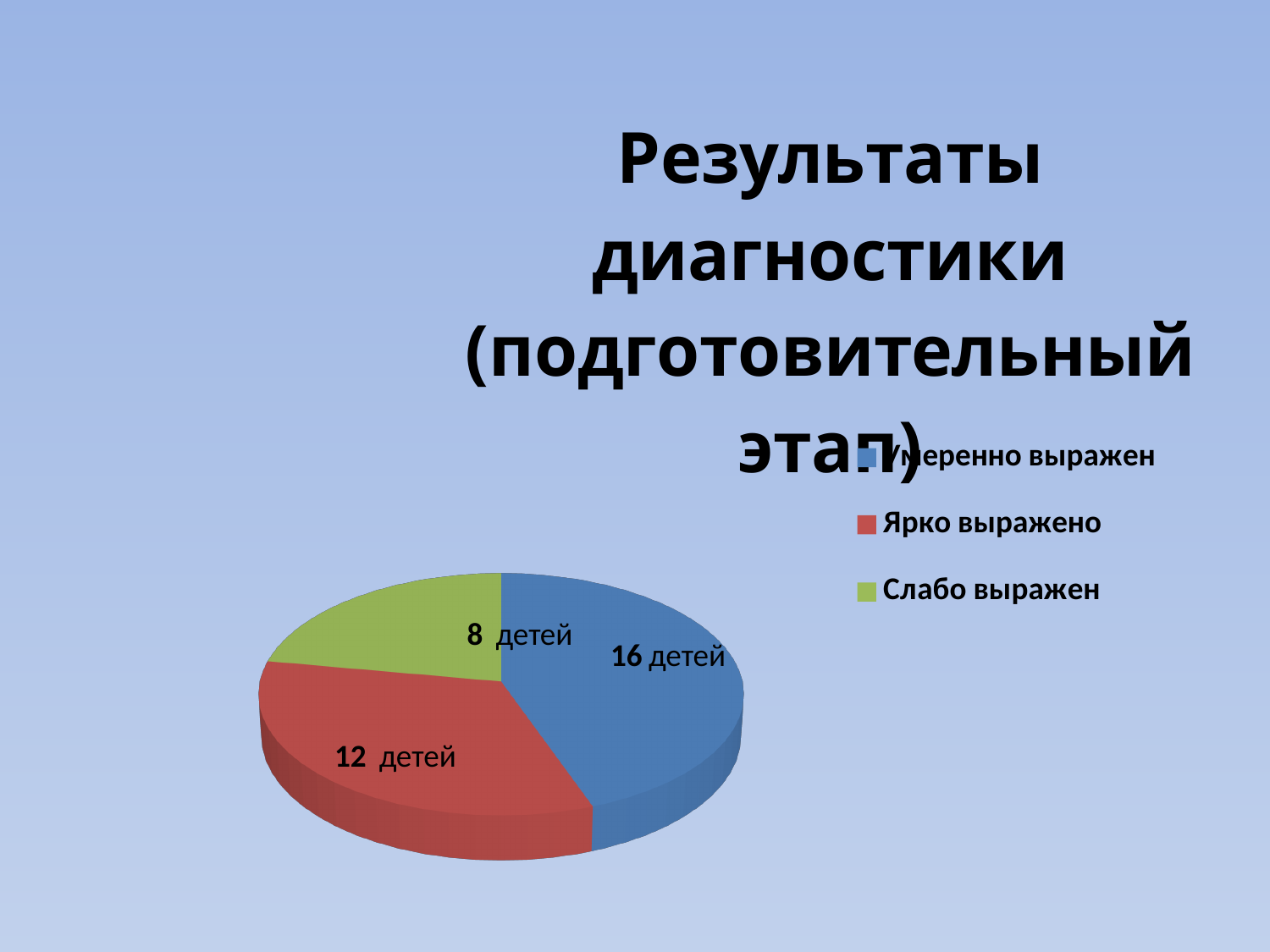
How many children are in the 'Слабо выражен' slice? 8 детей How many children are in the 'Умеренно выражен' slice? 16 детей Which category has the smallest slice of the pie? Слабо выражен Which is larger: the 'Ярко выражено' slice or the 'Слабо выражен' slice? Ярко выражено What is the total number of children across all slices of the pie? 36 What colour is the 'Ярко выражено' slice? red How many slices does the pie chart have? 3 Which category has the largest slice of the pie? Умеренно выражен What kind of chart is shown on the slide? pie chart How many more children are in 'Ярко выражено' than in 'Слабо выражен'? 4 How many more children are in 'Умеренно выражен' than in 'Слабо выражен'? 8 How many children are in the 'Ярко выражено' slice? 12 детей